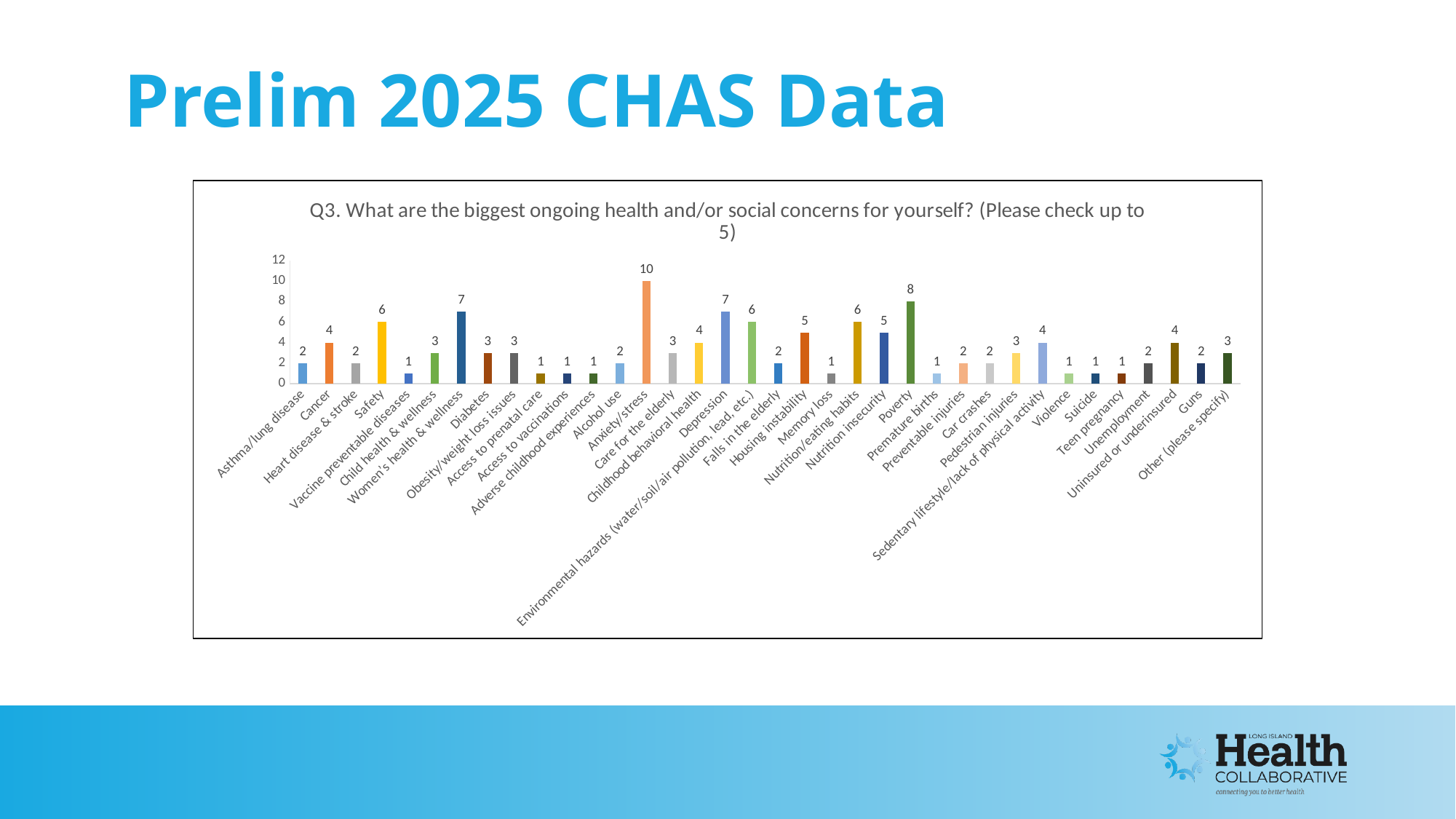
What type of chart is shown on the slide? bar chart Which category has the highest value? Anxiety/stress What is the value for Poverty? 8 Which has a larger value, Safety or Diabetes? Safety What is the value for Uninsured or underinsured? 4 What is the title of the chart? Q3. What are the biggest ongoing health and/or social concerns for yourself? (Please check up to 5) What is the value for Housing instability? 5 What is the difference between the values for Anxiety/stress and Poverty? 2 Is the value for Women's health & wellness greater or less than 4? greater What is the value for Anxiety/stress? 10 What is the difference between the values for Depression and Cancer? 3 How many categories are shown on the x axis? 36